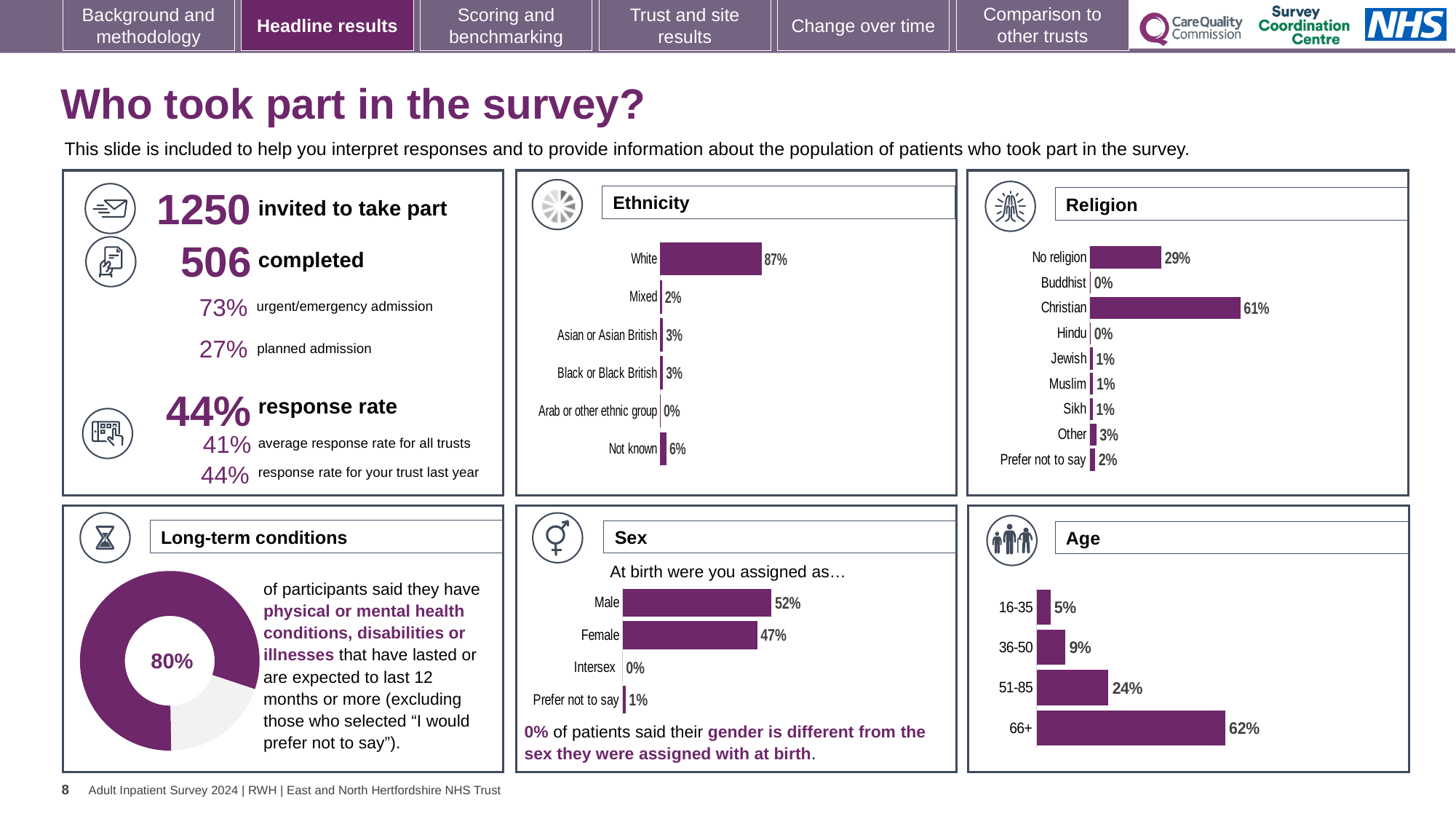
In the Age chart, what percentage of participants were aged 66+? 62% In the Sex chart, which is larger, Male or Female? Male In the Age chart, which age group has the lowest value? 16-35 In the Religion chart, what percentage of participants were Christian? 61% In the Sex chart, what percentage of participants selected Prefer not to say? 1% In the Religion chart, how many categories are shown? 9 In the Ethnicity chart, how many categories are shown? 6 In the Ethnicity chart, which category has the highest value? White In the Ethnicity chart, what percentage of participants were White? 87% What kind of chart is used in the Long-term conditions panel? Doughnut chart In the Age chart, do the values rise or fall as the age groups increase from 16-35 to 66+? rise In the Religion chart, what is the difference between the Christian and No religion values? 32%